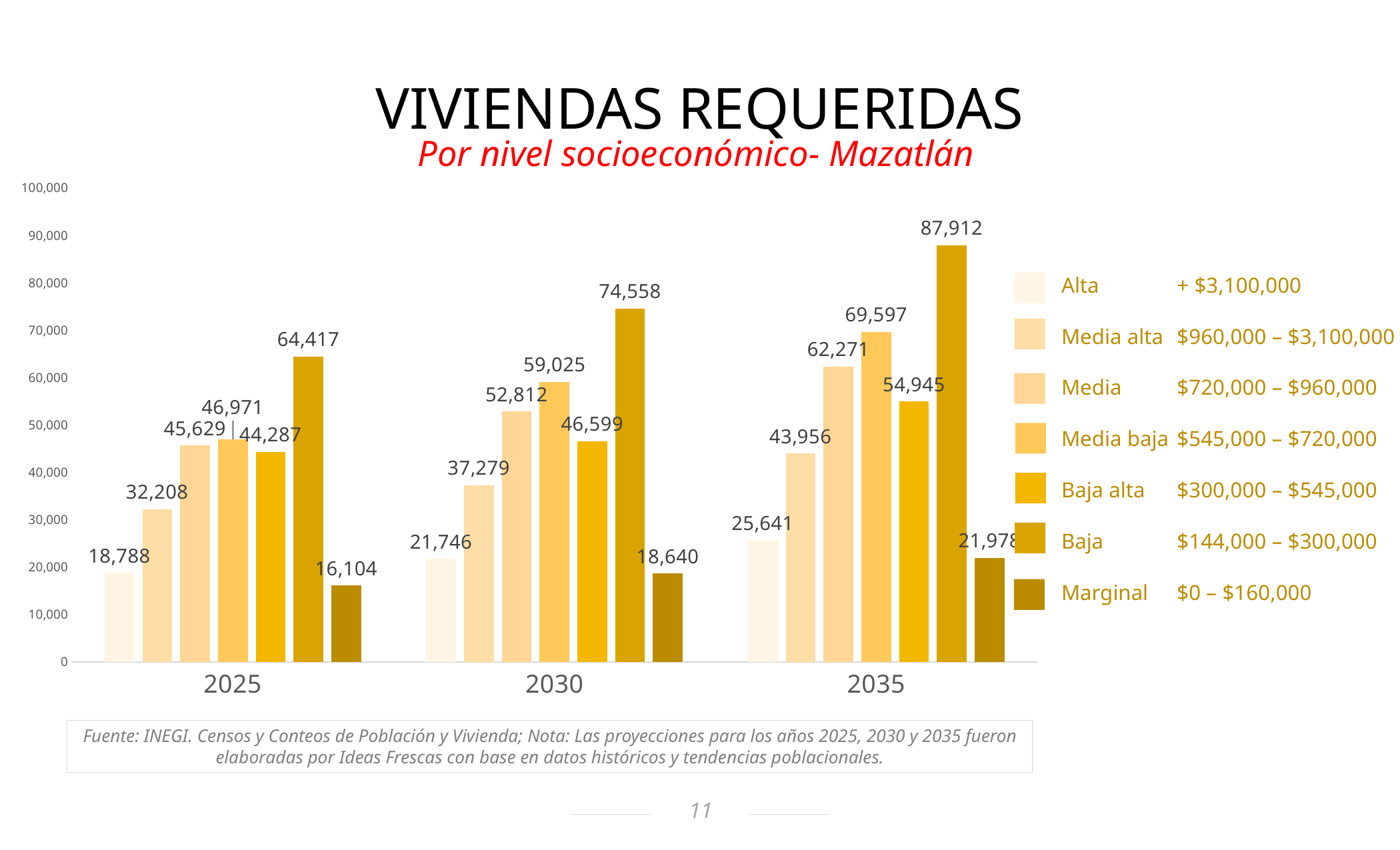
How many series does the legend list? 7 What is the value for Baja in 2035? 87,912 What price range does the legend give for the Media alta level? $960,000 – $3,100,000 How many year categories are shown on the x axis? 3 Which series has the highest value in 2030? Baja What type of chart is shown on the slide? Bar chart Which is larger in 2035, Media or Baja alta? Media Which series has the lowest value in 2025? Marginal Does the value for Baja rise or fall from 2025 to 2035? Rise What is the value for Alta in 2025? 18,788 What is the difference between the Baja values for 2035 and 2025? 23,495 What is the value for Media baja in 2030? 59,025